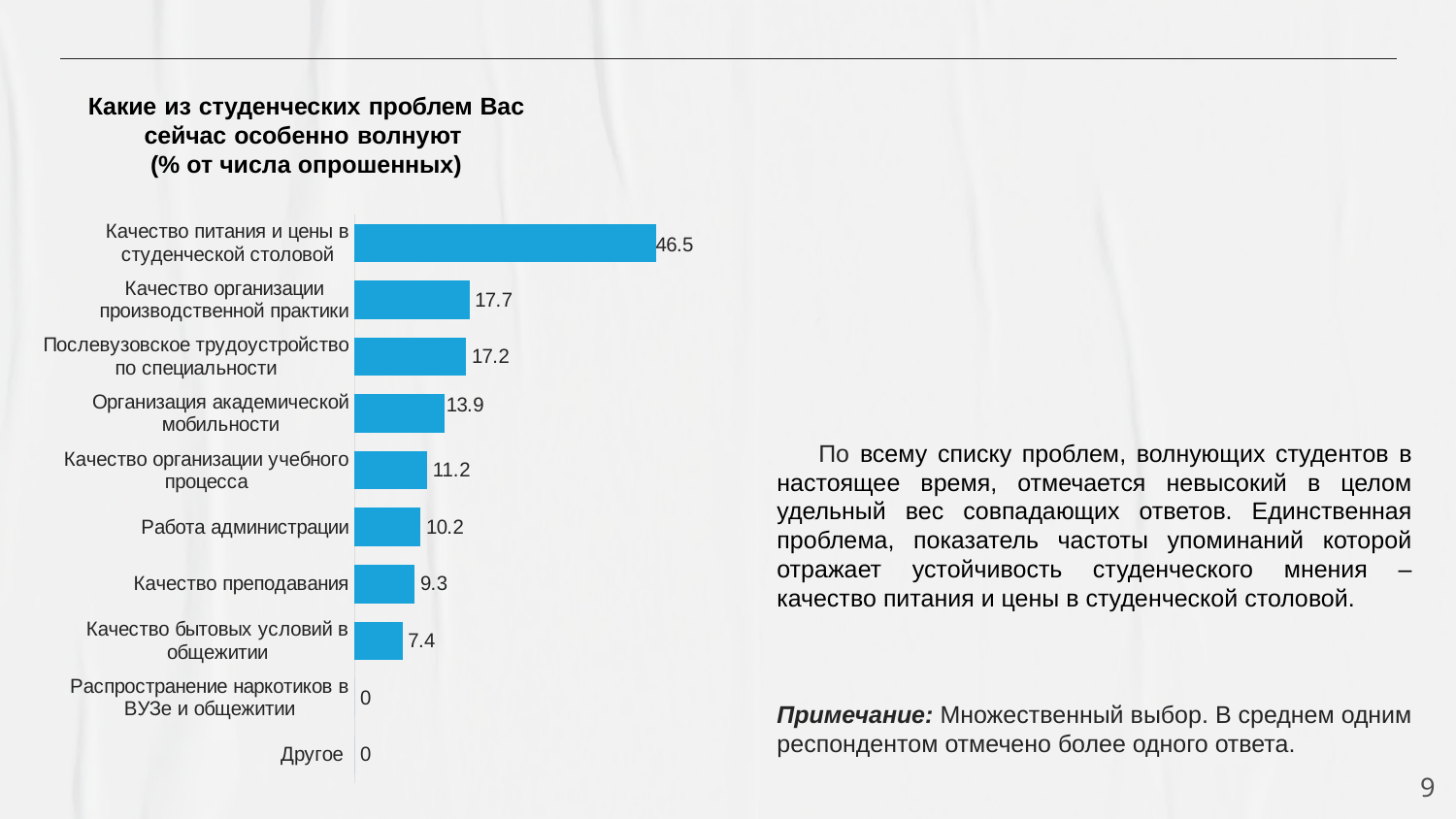
What is the difference between the values for "Качество питания и цены в студенческой столовой" and "Качество организации производственной практики"? 28.8 What type of chart is shown on the slide? Bar chart What is the difference between the values for "Организация академической мобильности" and "Качество организации учебного процесса"? 2.7 What is the value for "Качество бытовых условий в общежитии"? 7.4 What is the value for "Качество питания и цены в студенческой столовой"? 46.5 Do the bar values decrease or increase going from the top category to the bottom category? Decrease Which is larger: the value for "Качество преподавания" or the value for "Качество бытовых условий в общежитии"? Качество преподавания What is the value for "Работа администрации"? 10.2 How many categories are plotted in the chart? 10 How many categories have a value of 0? 2 What is the value for "Организация академической мобильности"? 13.9 Which category has the highest value? Качество питания и цены в студенческой столовой